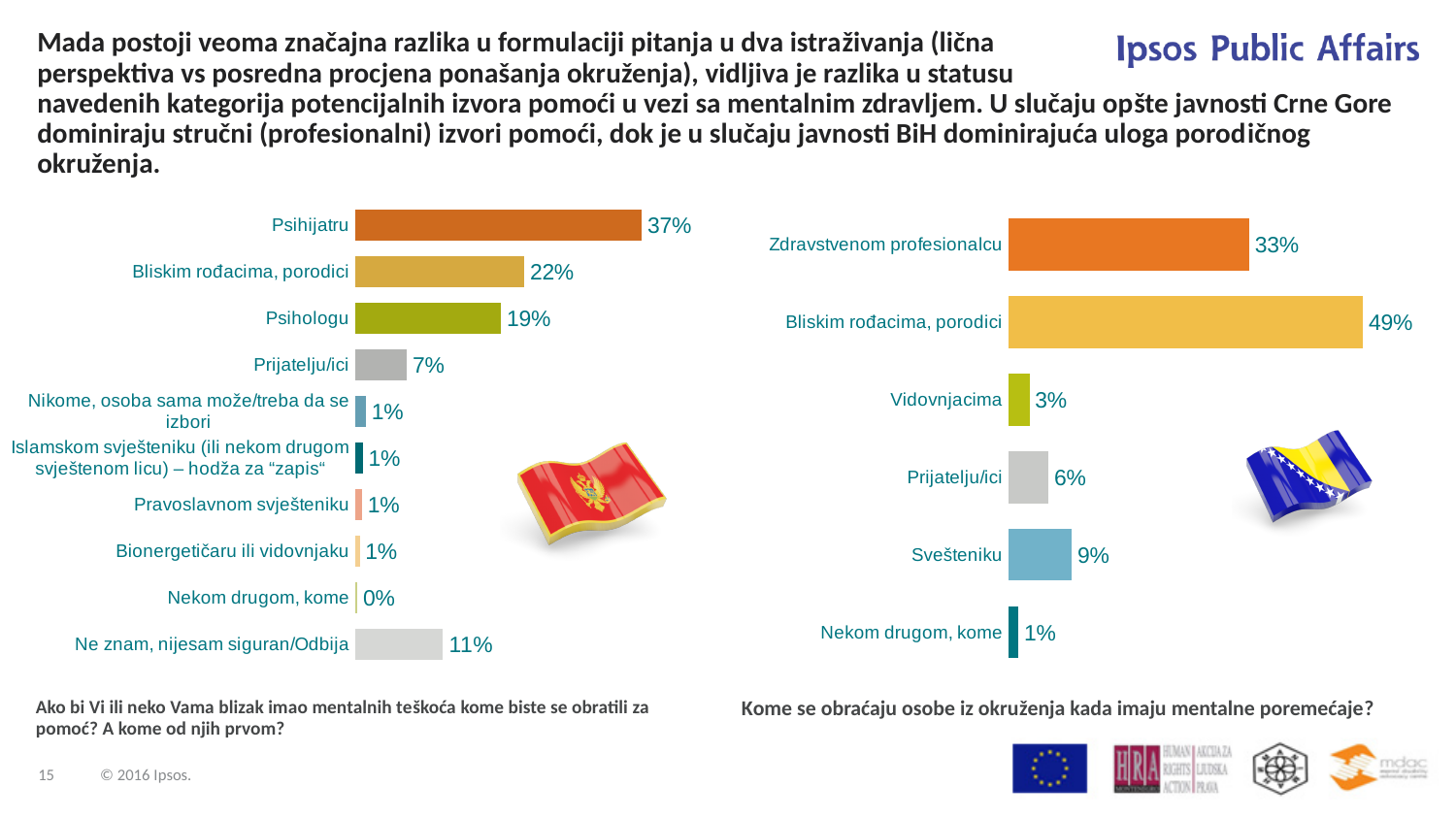
In the right chart, which category has the lowest value? Nekom drugom, kome In the right chart, what is the value for Bliskim rođacima, porodici? 49% In the left chart, what is the value for Ne znam, nijesam siguran/Odbija? 11% What type of chart is the left chart? Bar chart In the left chart, what is the difference between Psihijatru and Psihologu? 18% In the right chart, what is the difference between Bliskim rođacima, porodici and Zdravstvenom profesionalcu? 16% In the left chart, which category has the highest value? Psihijatru How many categories does the right chart show? 6 In the left chart, which is larger: Bliskim rođacima, porodici or Psihologu? Bliskim rođacima, porodici In the left chart, what is the value for Psihijatru? 37% In the left chart, which category has the lowest value? Nekom drugom, kome In the right chart, what is the value for Svešteniku? 9%